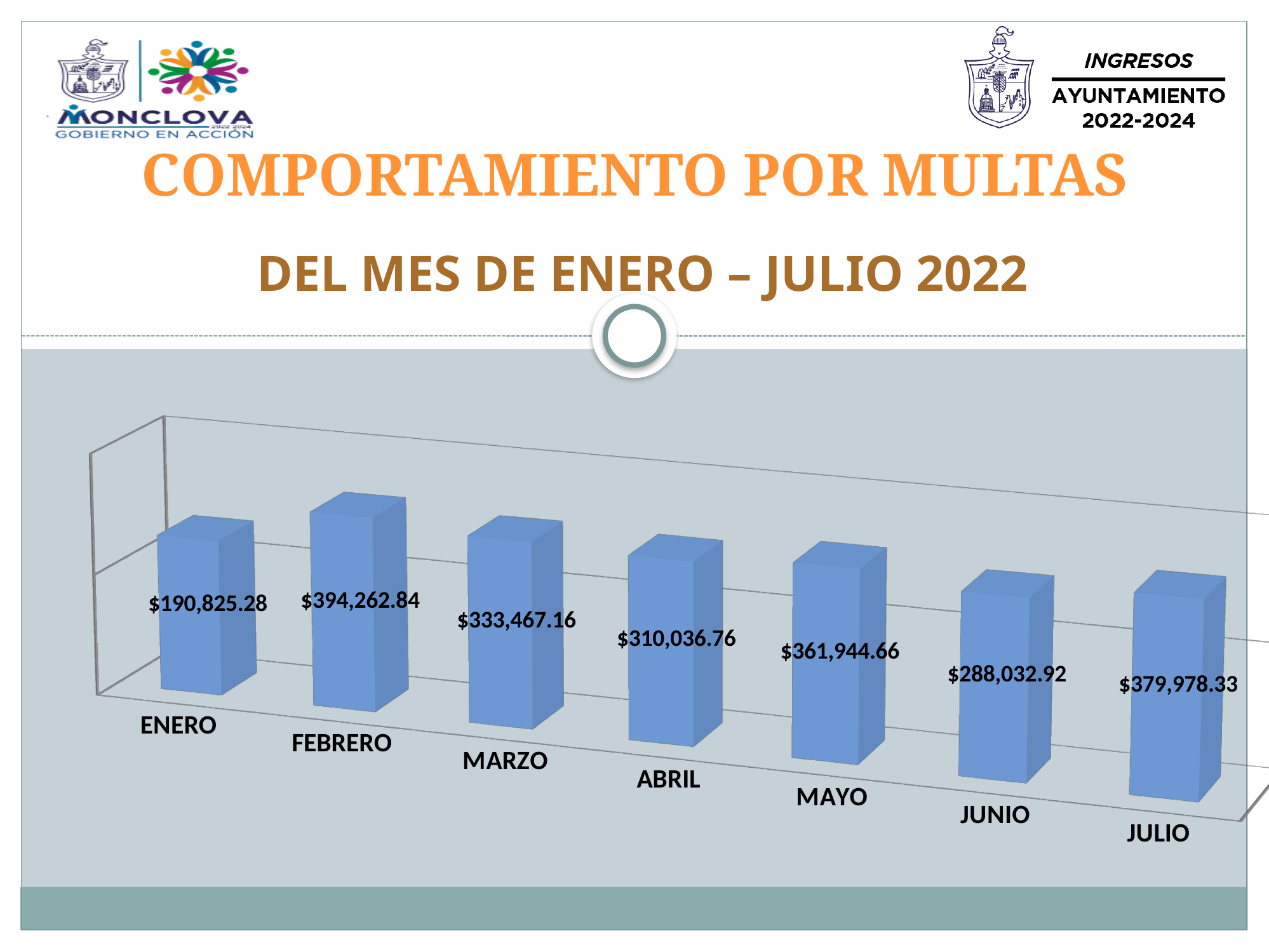
What kind of chart is shown on the slide? Bar chart Which is larger, the value for MAYO or the value for JUNIO? MAYO Does the value rise or fall from JUNIO to JULIO? Rise What is the difference between the values for JULIO and JUNIO? $91,945.41 How many months are shown in the chart? 7 What is the difference between the values for FEBRERO and ENERO? $203,437.56 What is the value for FEBRERO? $394,262.84 What is the value for MAYO? $361,944.66 Which month has the highest value? FEBRERO Which month has the lowest value? ENERO Which is larger, the value for MARZO or the value for ABRIL? MARZO What is the value for JULIO? $379,978.33